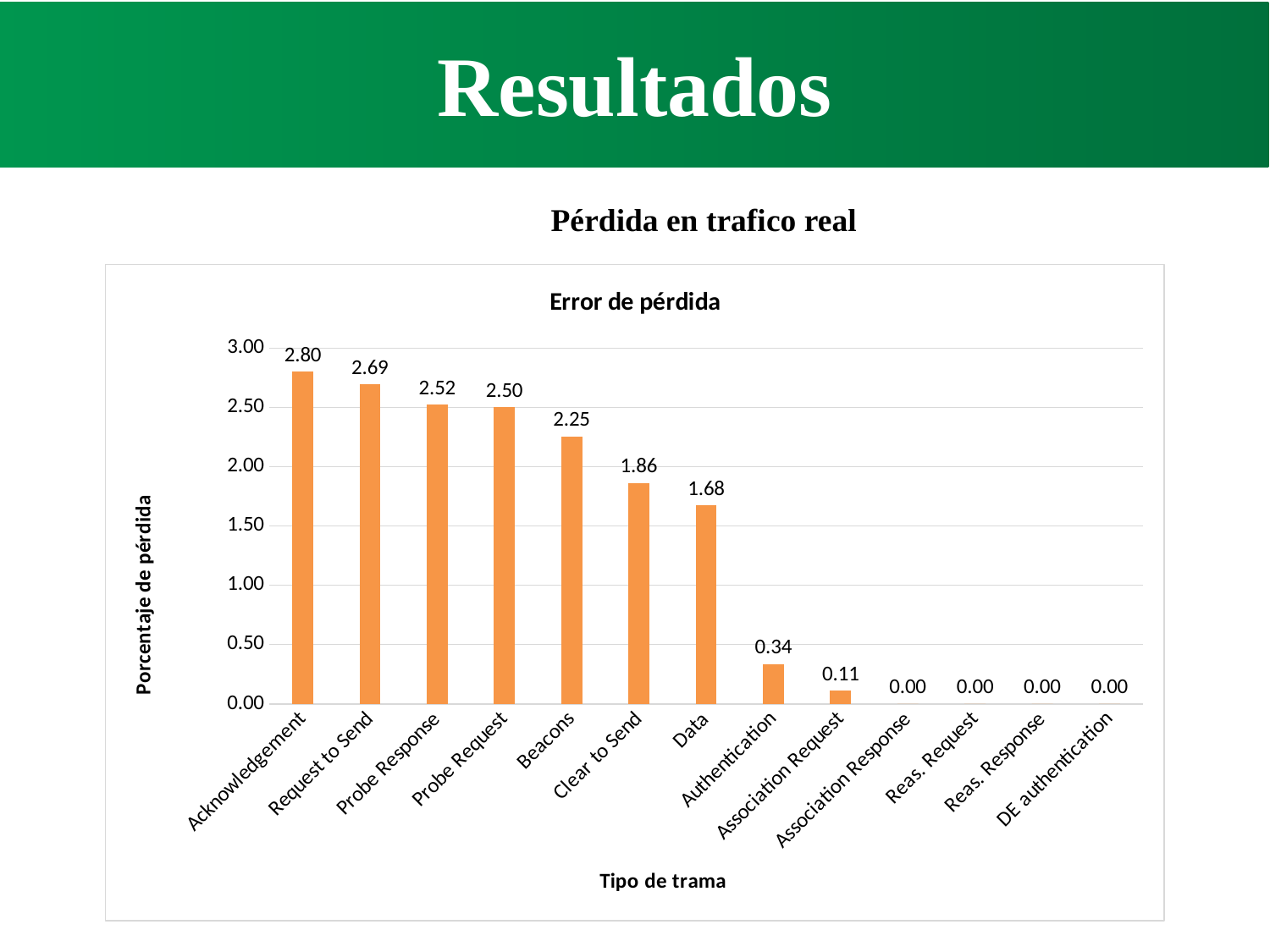
What is the difference between the values for Clear to Send and Data? 0.18 What is the value for Acknowledgement? 2.80 How many categories have a value of 0.00? 4 What is the title of the chart? Error de pérdida What is the value for Authentication? 0.34 How many categories are shown on the x axis? 13 Which category has the highest value? Acknowledgement What is the difference between the values for Acknowledgement and Request to Send? 0.11 Is the value for Probe Response greater or less than 2.00? greater What kind of chart is shown? bar chart What is the value for Beacons? 2.25 Which is larger, the value for Beacons or the value for Clear to Send? Beacons